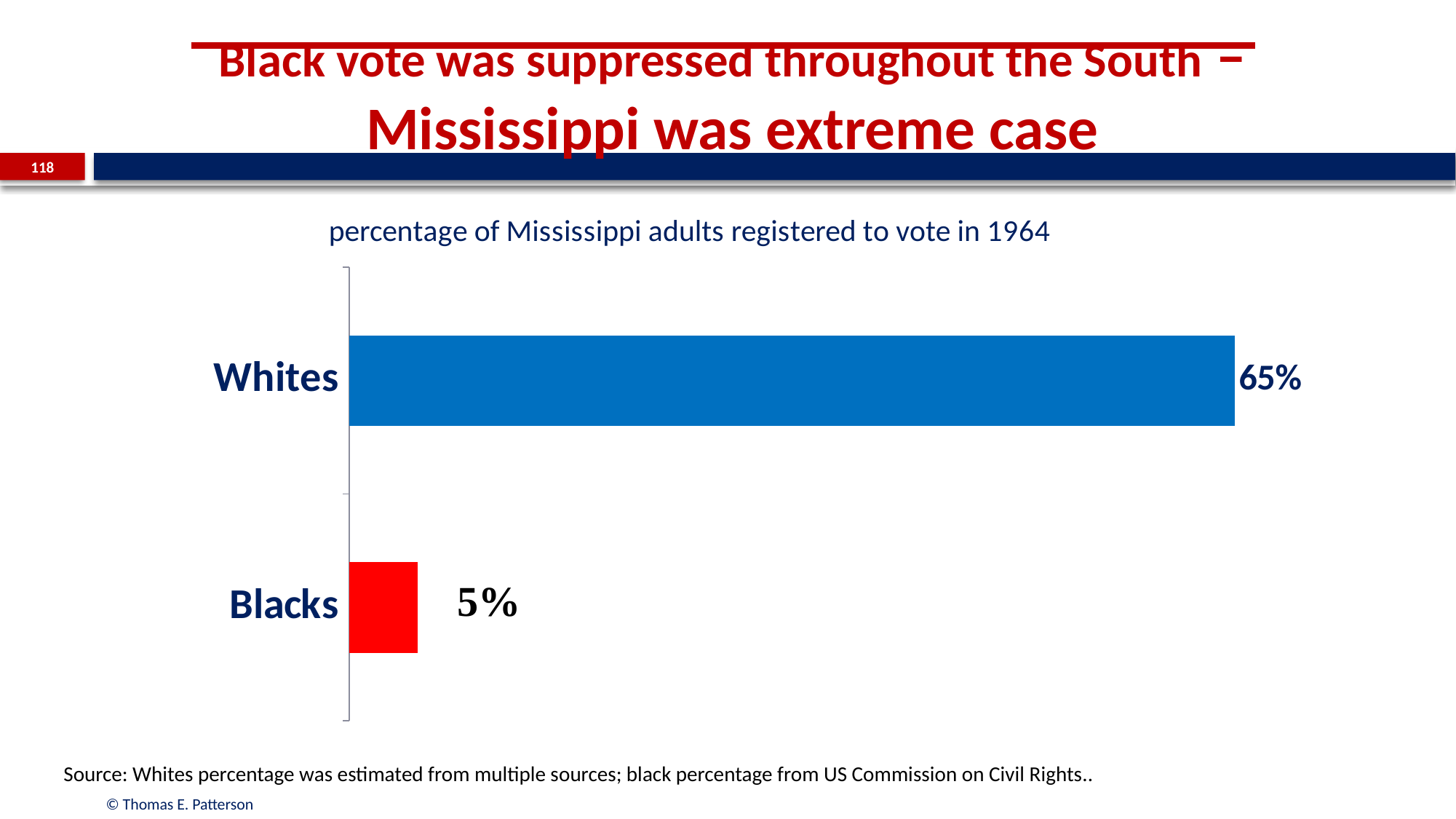
What is the difference in percentage points between the Whites and Blacks registration rates? 60 What kind of chart is shown on the slide? bar chart What percentage of Mississippi white adults were registered to vote in 1964? 65% What colour is the bar for Blacks? red Is the registration percentage for Whites larger or smaller than that for Blacks? larger What is the title of the chart? percentage of Mississippi adults registered to vote in 1964 Which group has the lowest percentage of adults registered to vote? Blacks What percentage of Mississippi Black adults were registered to vote in 1964? 5% How many categories are shown in the chart? 2 Which group has the higher percentage of adults registered to vote? Whites